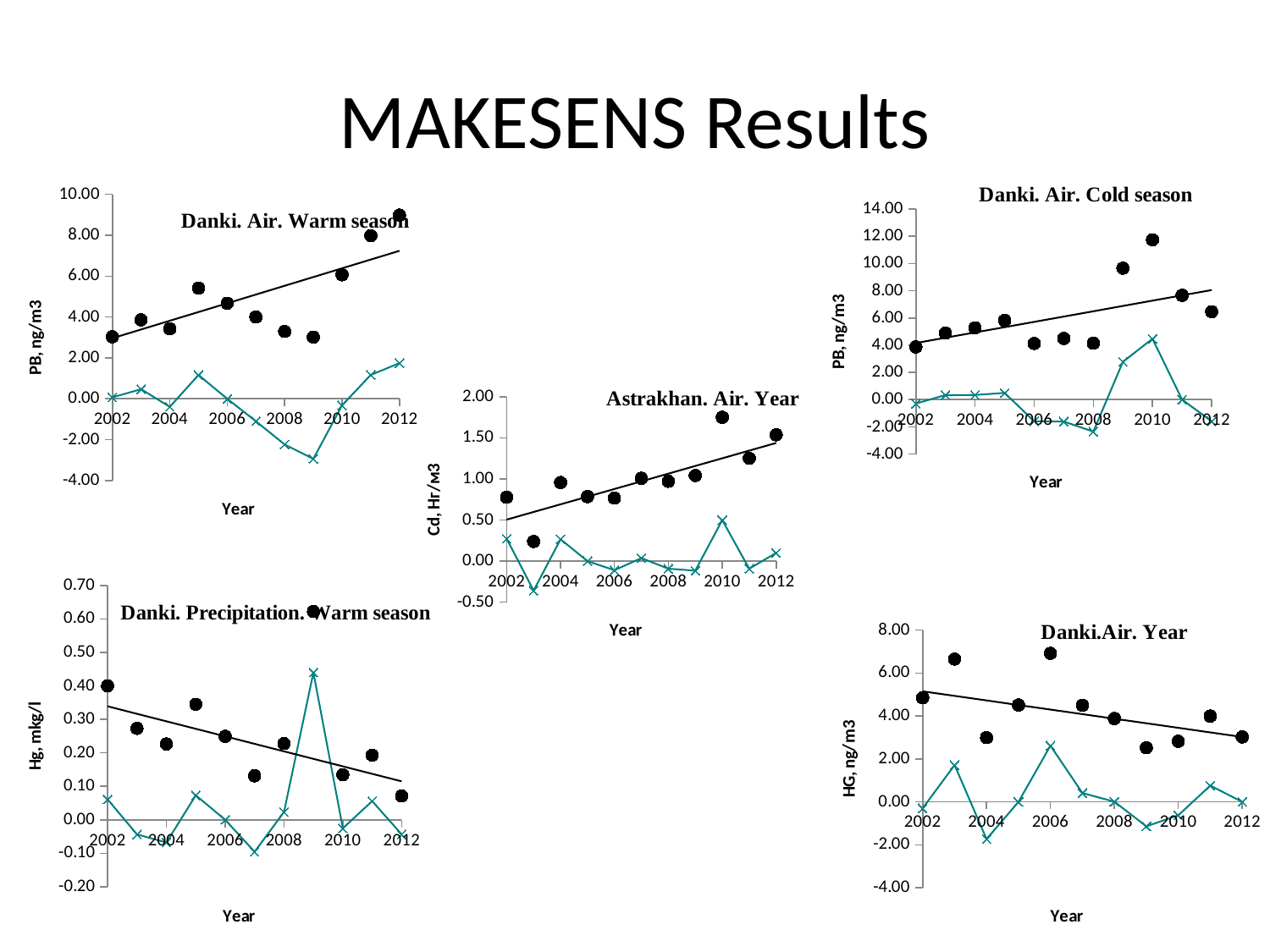
In the 'Danki. Air. Cold season' chart, which year has the highest PB data point? 2010 How many charts are shown on the slide? 5 In the 'Astrakhan. Air. Year' chart, which year has the highest Cd data point? 2010 In the 'Danki. Air. Cold season' chart, which year has the larger PB data point, 2010 or 2012? 2010 What is the y-axis label of the 'Danki. Precipitation. Warm season' chart? Hg, mkg/l In the 'Danki. Air. Warm season' chart, does the fitted trend line rise or fall from 2002 to 2012? rise In the 'Danki.Air. Year' chart, is the HG value for 2006 greater or less than 6.00? greater In the 'Danki. Air. Cold season' chart, is the PB value for 2010 greater or less than 10.00? greater In the 'Danki. Precipitation. Warm season' chart, does the fitted trend line rise or fall across the years? fall In the 'Danki. Air. Warm season' chart, which year has the highest PB data point? 2012 In the 'Danki.Air. Year' chart, does the fitted trend line rise or fall from 2002 to 2012? fall In the 'Danki. Air. Warm season' chart, is the PB value for 2002 greater or less than 4.00? less